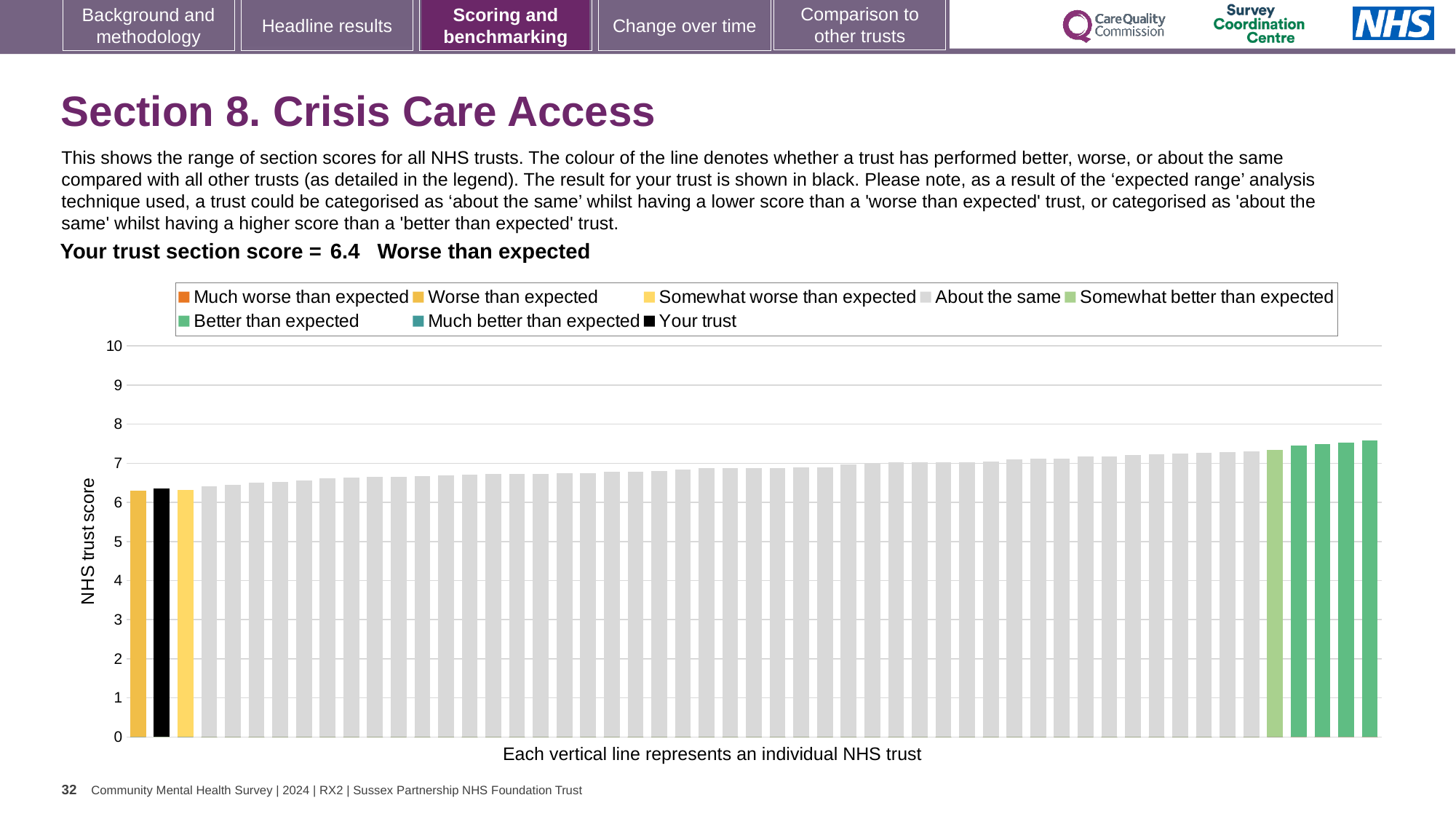
Which is larger, the value for your trust (black bar) or the value for the rightmost bar? the rightmost bar How many bars are coloured as 'Better than expected' (dark green)? 4 Is the value for the rightmost bar greater or less than 7? greater What colour is the bar representing your trust? black Is the value for the rightmost bar greater or less than 8? less What is the label on the vertical axis of the chart? NHS trust score How many entries does the chart legend list? 8 What is the section score for your trust shown on the slide? 6.4 What kind of chart is shown on the slide? bar chart Which performance category is your trust's section score assigned to? Worse than expected Is the value for your trust (the black bar) greater or less than 7? less Do the bar values rise or fall from left to right along the x axis? rise